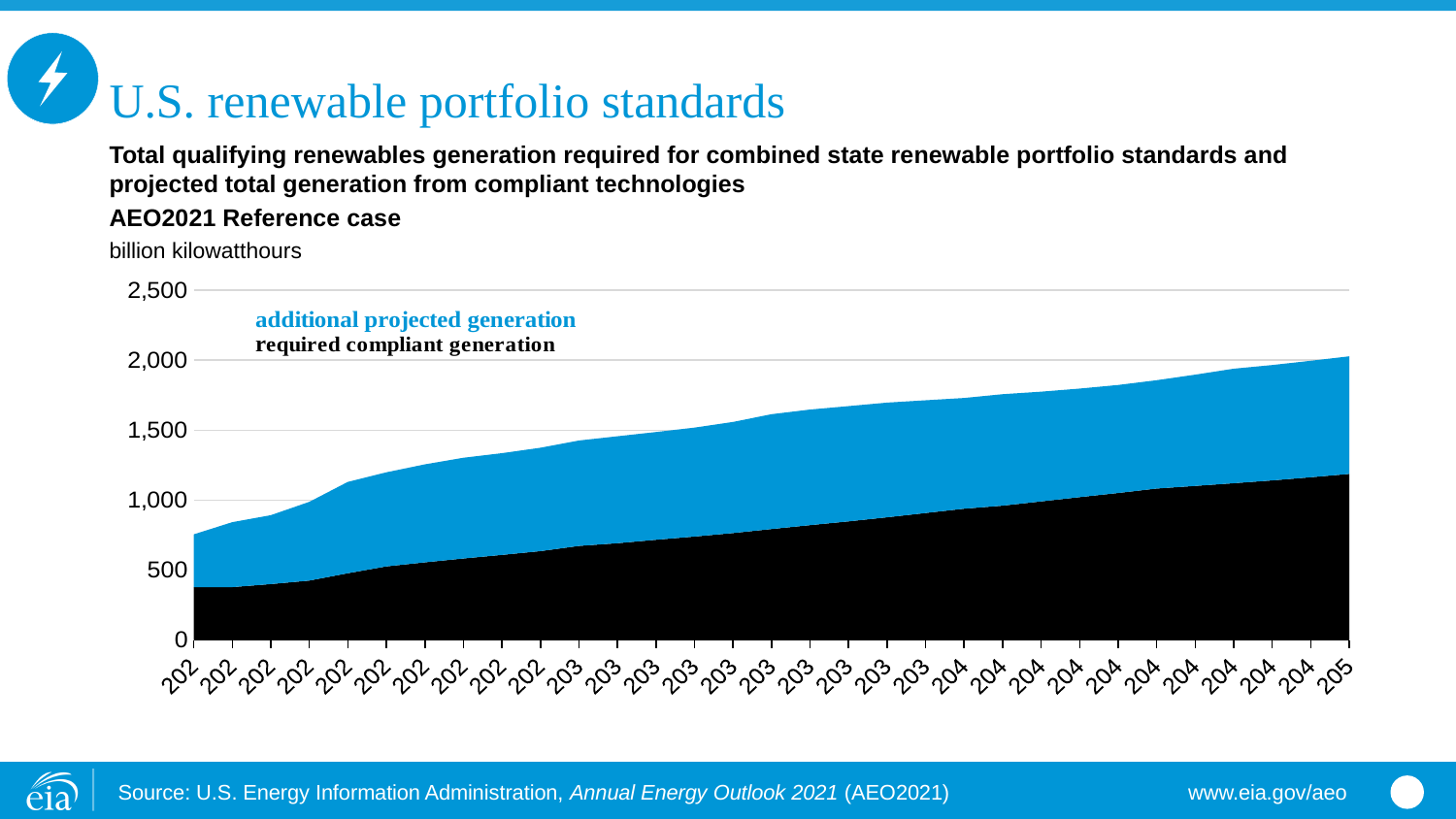
Is the required compliant generation at the last year on the x axis greater or less than 1,000? greater Is the combined total of both series at the last year on the x axis greater or less than 1,500? greater Which colour represents 'additional projected generation' in the chart? blue Is the combined total of both series at the first year on the x axis greater or less than 1,000? less Does the required compliant generation rise or fall over the years shown on the x axis? rise What kind of chart is shown on the slide? area chart How many series does the chart's legend list? 2 Does the total of required compliant generation plus additional projected generation rise or fall across the x axis? rise What unit is the y axis of the chart measured in? billion kilowatthours